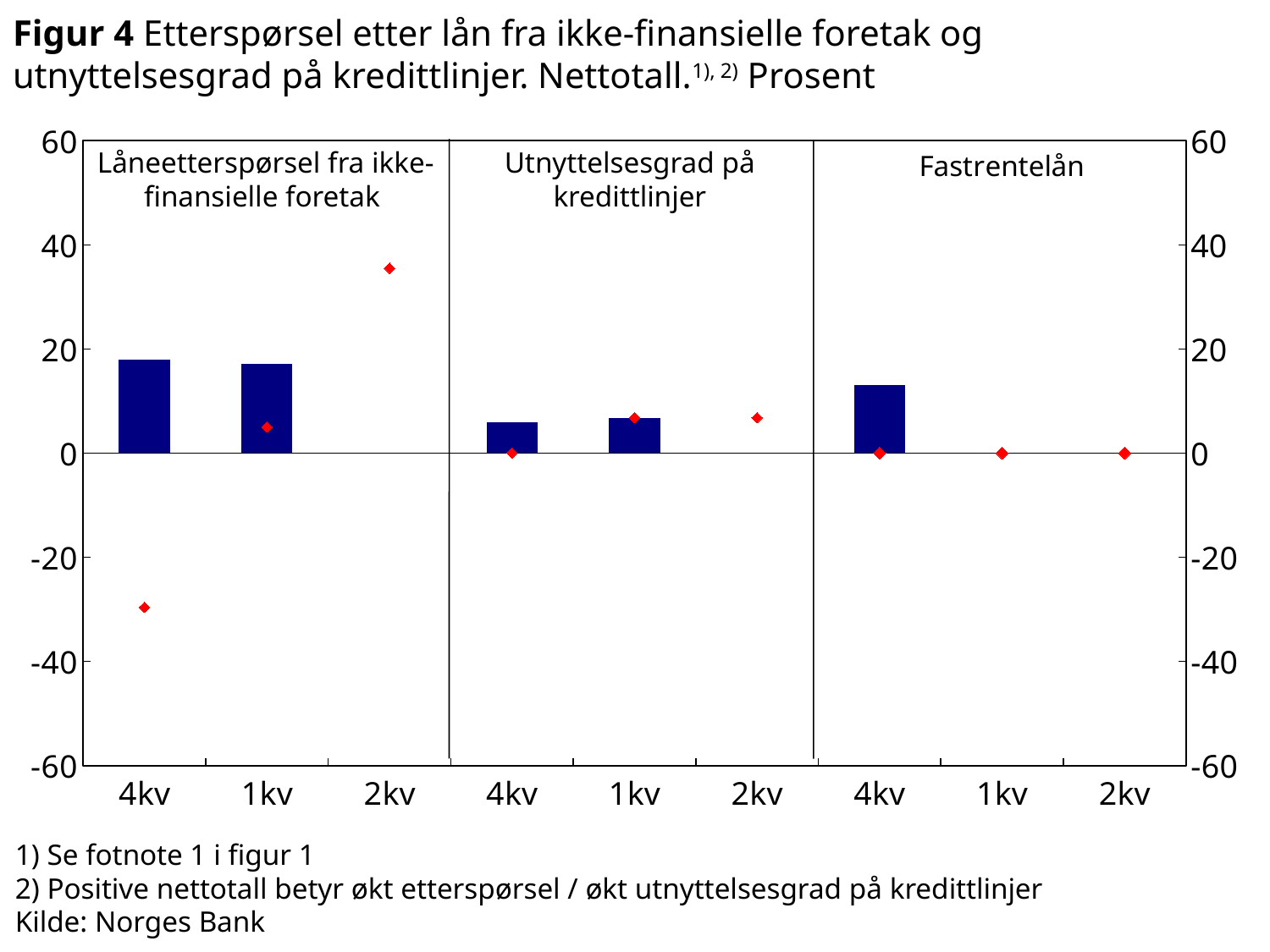
Is the bar for 4kv in the 'Fastrentelån' panel greater or less than 20? less How many panels does the chart have? 3 Is the bar for 4kv in the 'Låneetterspørsel fra ikke-finansielle foretak' panel greater or less than 0? greater Do the red diamonds in the 'Låneetterspørsel fra ikke-finansielle foretak' panel rise or fall from 4kv to 2kv? rise Which quarter and panel has the lowest red diamond? 4kv in Låneetterspørsel fra ikke-finansielle foretak Which is larger: the bar for 4kv in the 'Fastrentelån' panel or the bar for 4kv in the 'Utnyttelsesgrad på kredittlinjer' panel? Fastrentelån 4kv What is the title of the third panel of the chart? Fastrentelån What kind of chart is shown on the slide? bar chart Is the red diamond for 2kv in the 'Låneetterspørsel fra ikke-finansielle foretak' panel greater or less than 20? greater How many quarters are shown on the x axis of each panel? 3 Which panel contains the tallest bar? Låneetterspørsel fra ikke-finansielle foretak